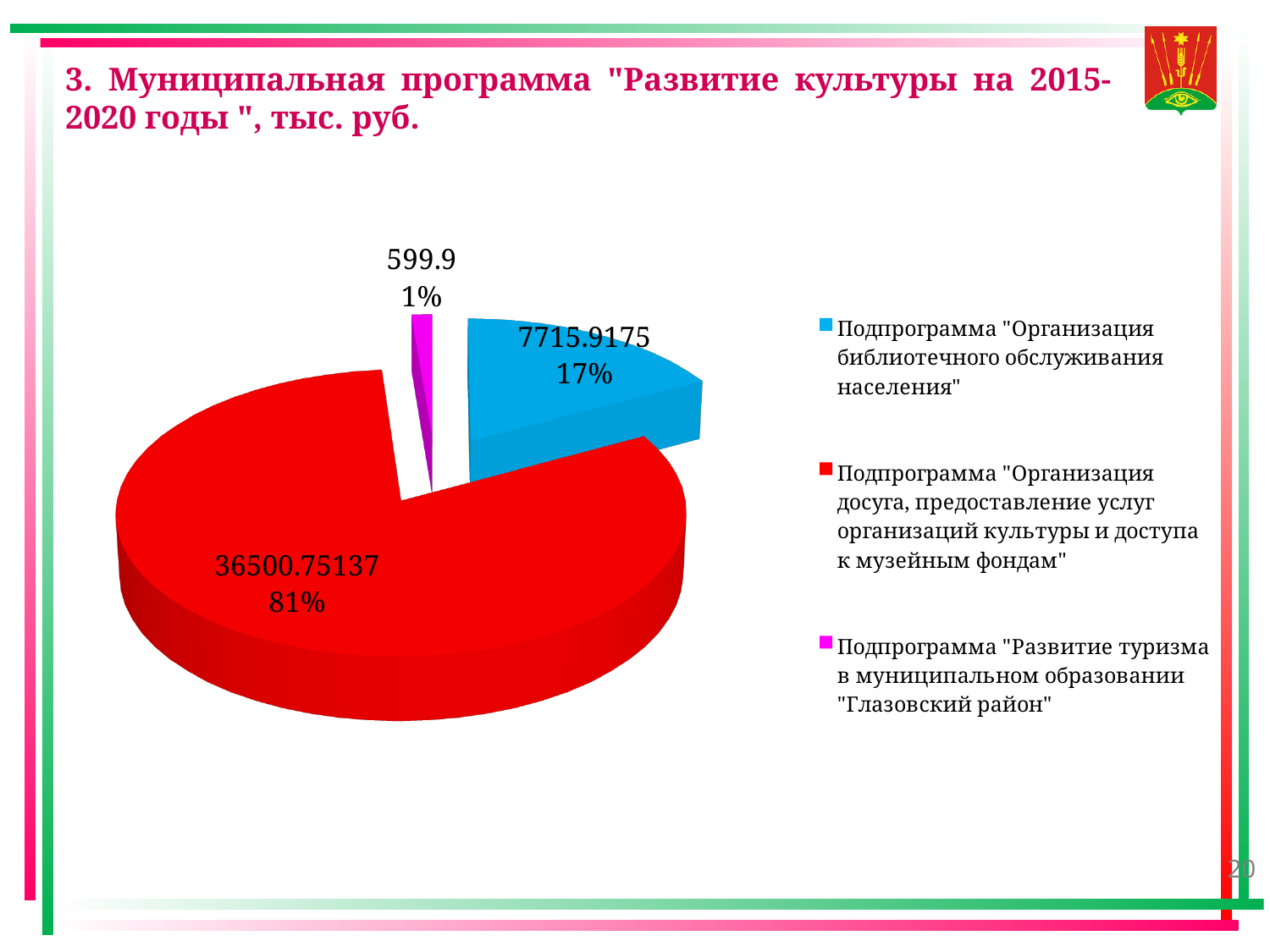
How many slices does the pie chart have? 3 What is the value for the subprogram "Развитие туризма в муниципальном образовании "Глазовский район""? 599.9 What kind of chart is shown on the slide? pie chart What colour is the slice for the subprogram "Развитие туризма в муниципальном образовании "Глазовский район""? magenta What is the value for the subprogram "Организация библиотечного обслуживания населения"? 7715.9175 What share of the pie does the subprogram "Организация досуга, предоставление услуг организаций культуры и доступа к музейным фондам" represent? 81% What share of the pie does the subprogram "Организация библиотечного обслуживания населения" represent? 17% What is the value for the subprogram "Организация досуга, предоставление услуг организаций культуры и доступа к музейным фондам"? 36500.75137 What is the difference between the value for the library services subprogram and the value for the tourism development subprogram? 7116.0175 Which subprogram has the smallest slice of the pie? Подпрограмма "Развитие туризма в муниципальном образовании "Глазовский район"" Which subprogram has the largest slice of the pie? Подпрограмма "Организация досуга, предоставление услуг организаций культуры и доступа к музейным фондам" How many entries does the legend list? 3